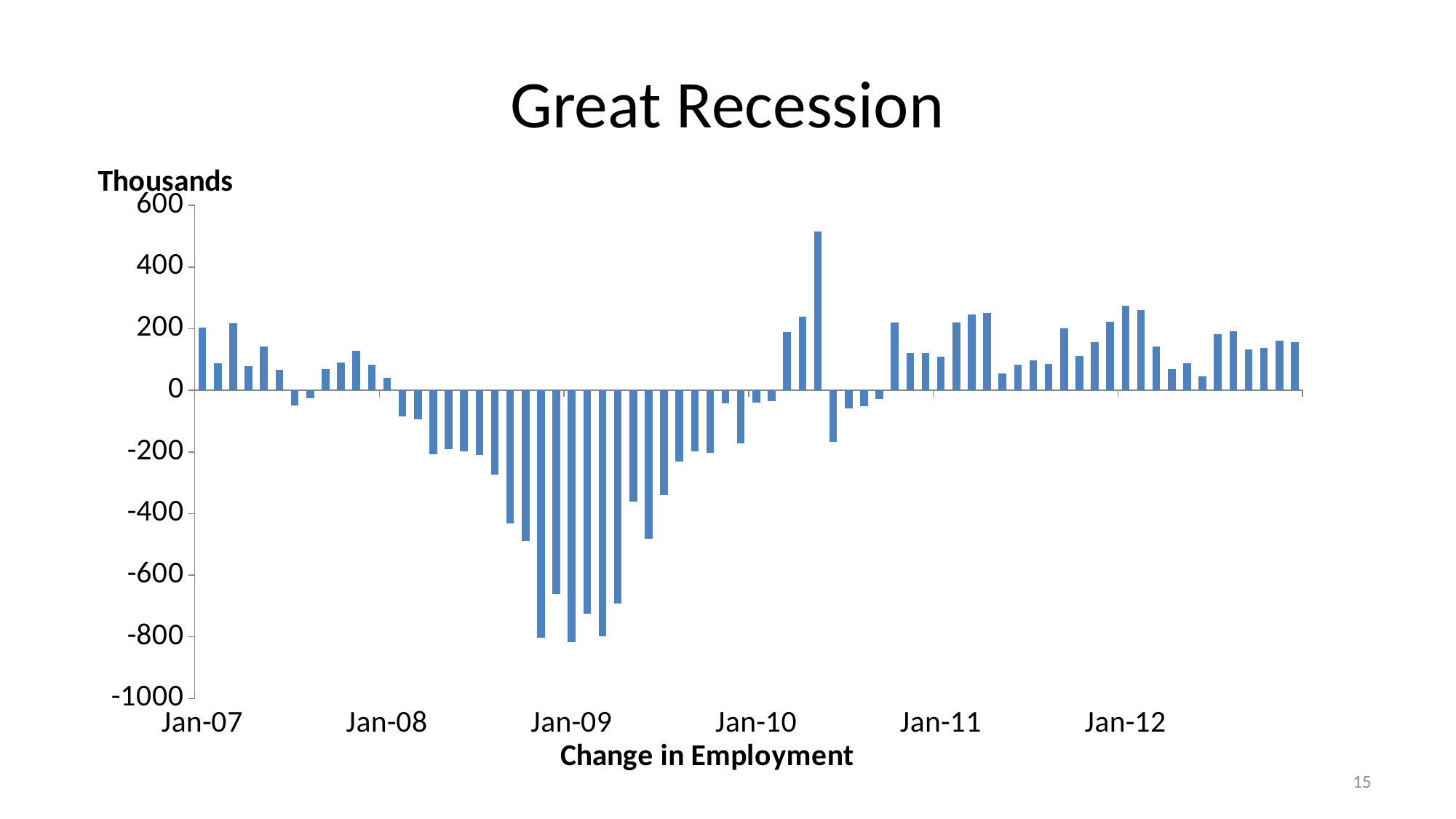
Is the value for Jan-11 greater or less than 0? greater Do the values generally rise or fall between Jan-08 and Jan-09? fall Is the value for Jan-10 greater or less than 0? less What is the title of the chart? Great Recession What label is shown on the horizontal axis of the chart? Change in Employment What kind of chart is shown on the slide? bar chart Do the values generally rise or fall between Jan-09 and Jan-10? rise Is the value for Jan-08 greater or less than 100? less